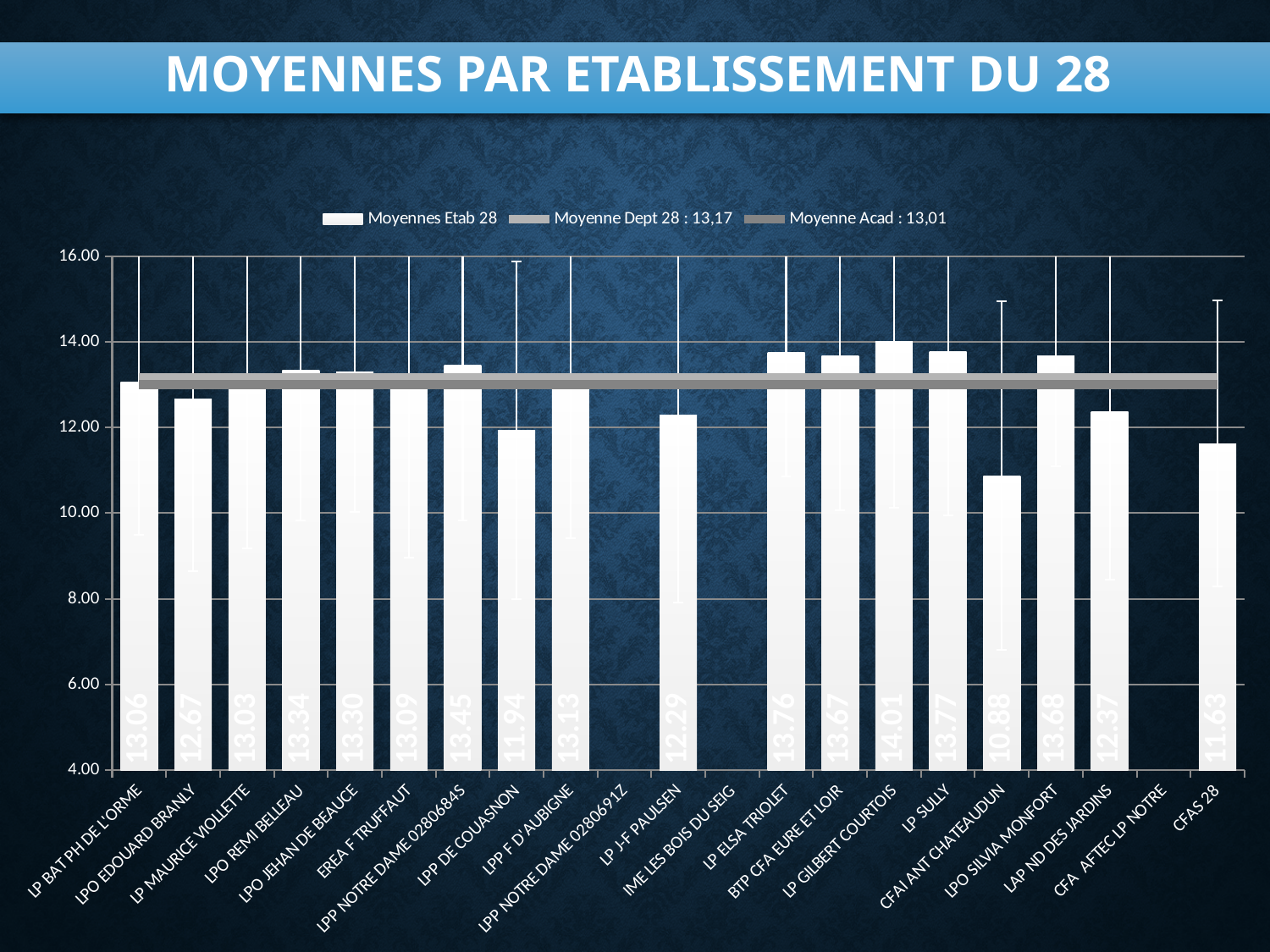
How many series does the legend list? 3 What is the value for LPP DE COUASNON? 11.94 Which is larger, the value for LPP DE COUASNON or the value for CFAS 28? LPP DE COUASNON What type of chart is shown on the slide? bar chart Is the value for CFAI ANT CHATEAUDUN greater or less than 12.00? less What is the value for LP GILBERT COURTOIS? 14.01 What is the difference between the values for LP GILBERT COURTOIS and CFAI ANT CHATEAUDUN? 3.13 What is the value for LPO SILVIA MONFORT? 13.68 Which establishment has the lowest value? CFAI ANT CHATEAUDUN What is the title of the chart? MOYENNES PAR ETABLISSEMENT DU 28 Which establishment has the highest value? LP GILBERT COURTOIS According to the legend, what is the value of Moyenne Dept 28? 13,17